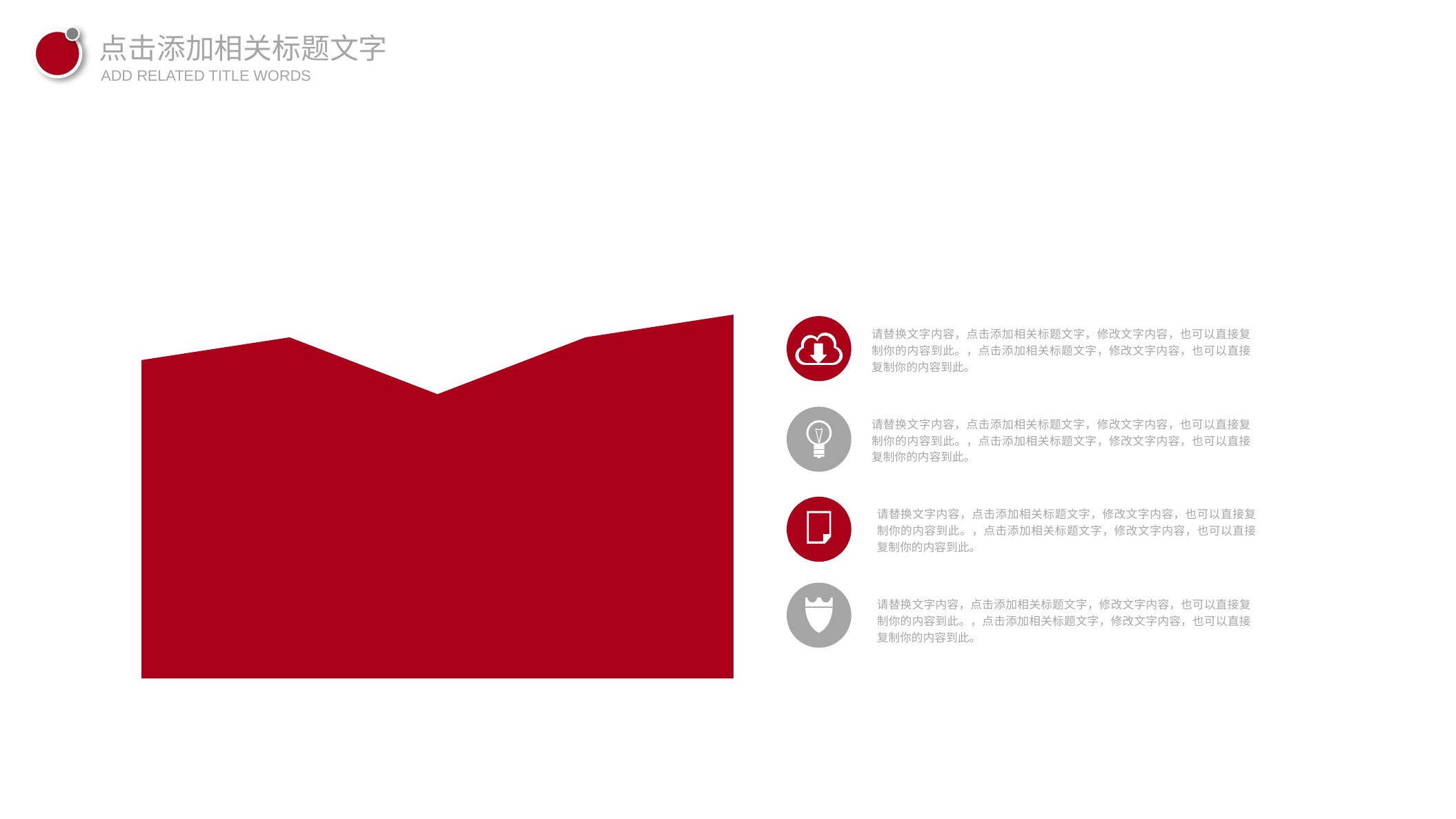
What colour is the filled area in the chart on the left? red What kind of chart is shown on the left of the slide? area chart In the area chart on the left, which point is the lowest: the second point or the third point from the left? the third point In the area chart on the left, does the value rise or fall between the fourth and fifth points? rise How many data points does the area chart on the left have? 5 In the area chart on the left, does the value rise or fall between the second and third points? fall In the area chart on the left, which point is the highest: the first (leftmost) or the last (rightmost)? the last (rightmost) Does the area chart on the left show any axis labels or data labels? no